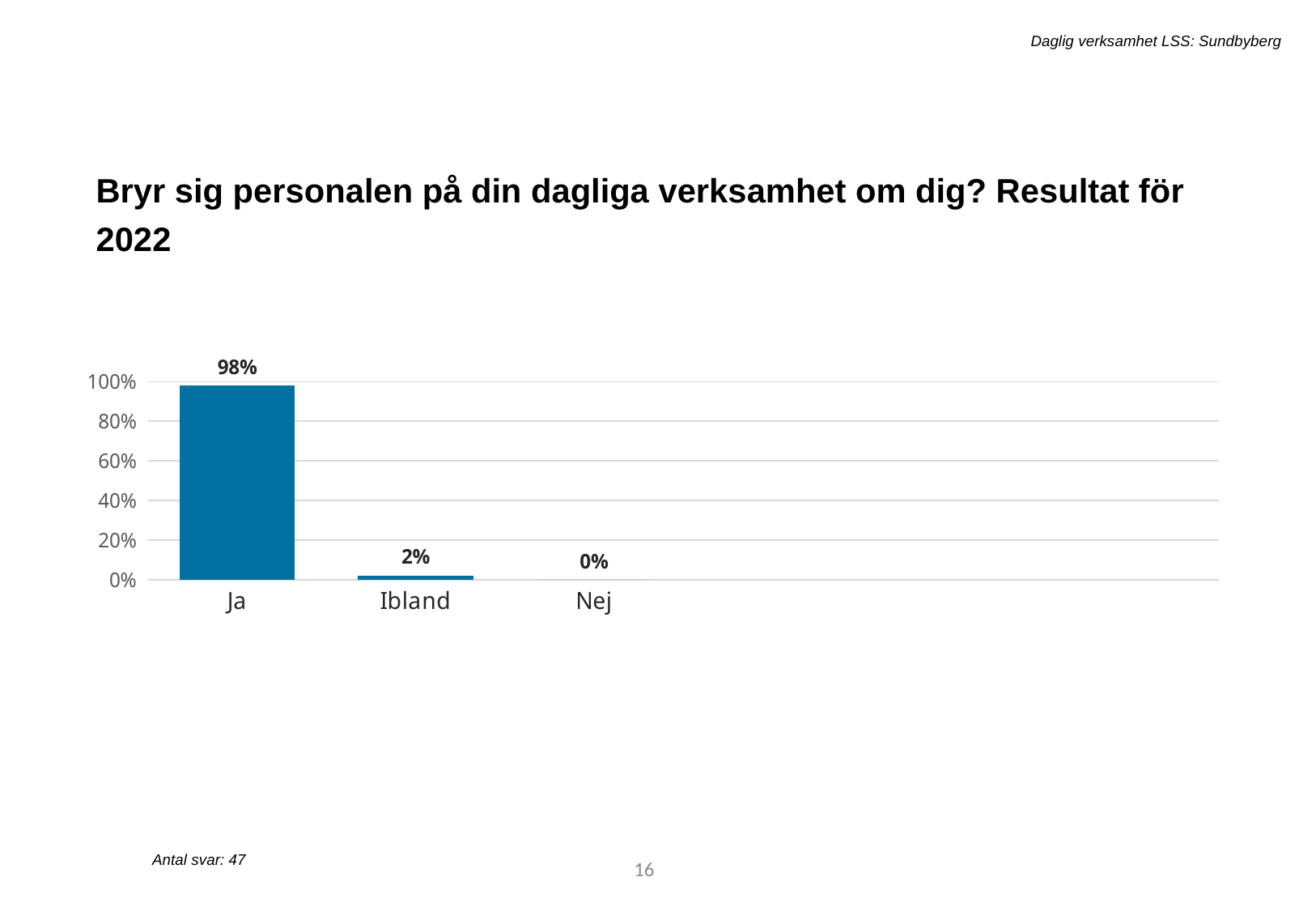
What is the value for Ja? 98% Is the value for Ja greater or less than 80%? greater What is the value for Ibland? 2% What is the difference between the values for Ja and Ibland? 96% What kind of chart is shown on the slide? bar chart How many responses (Antal svar) does the slide report? 47 Which category has the highest value? Ja Do the values rise or fall from left to right along the x axis? fall Which is larger, the value for Ibland or the value for Nej? Ibland How many categories are shown on the x axis? 3 What is the value for Nej? 0% Which category has the lowest value? Nej